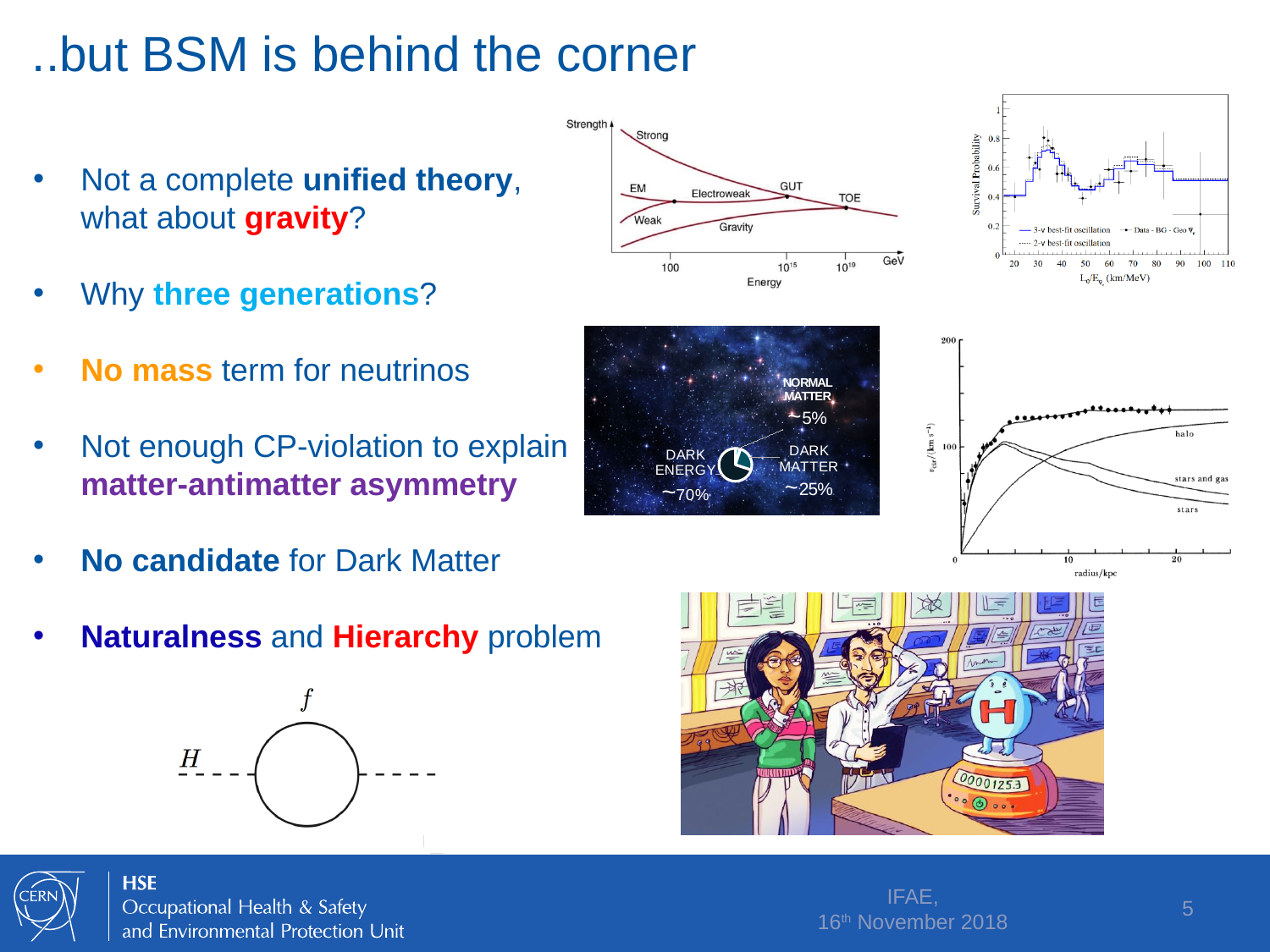
In the Strength versus Energy plot at the top centre, what unit is shown on the Energy axis? GeV In the pie chart over the starry background, what share is labelled for Normal Matter? ~5% In the pie chart over the starry background, what share is labelled for Dark Energy? ~70% In the Survival Probability plot at the top right, what is the label of the x axis? L0/Eν̄e (km/MeV) In the pie chart over the starry background, which component has the smallest slice? Normal Matter In the pie chart over the starry background, which component has the largest slice? Dark Energy In the pie chart over the starry background, how many slices are labelled? 3 In the Survival Probability plot at the top right, how many entries does the legend list? 3 In the rotation-curve plot on the right with radius/kpc on the x axis, how many curves are labelled (halo, stars and gas, stars)? 3 In the pie chart over the starry background, what share is labelled for Dark Matter? ~25% What kind of chart is the one over the starry background showing Dark Energy, Dark Matter and Normal Matter? pie chart In the Strength versus Energy plot at the top centre, does the Strong curve rise or fall as Energy increases? fall